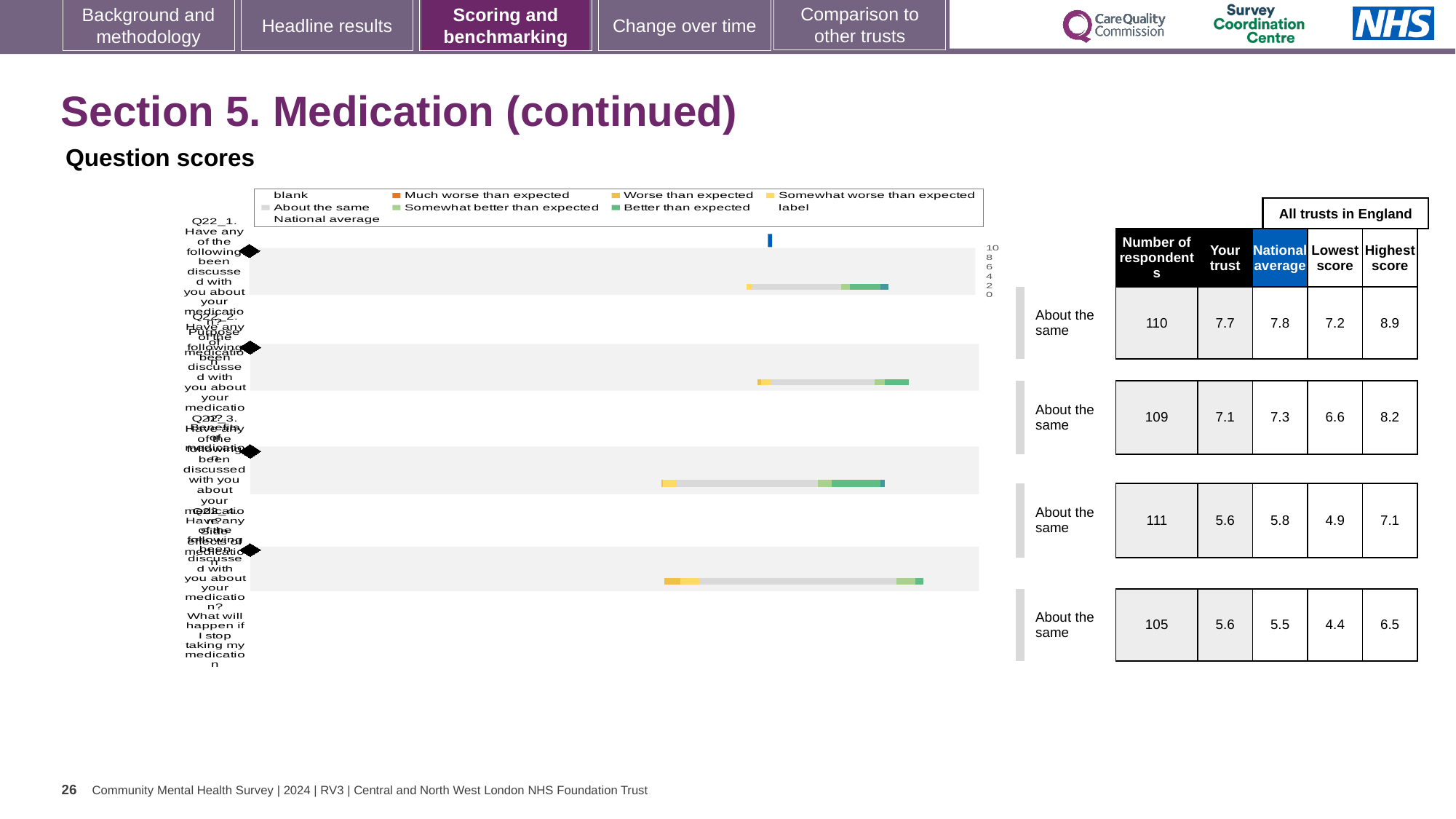
What benchmark category is shown for every question row in the chart? About the same In the table next to the chart, what is the 'Your trust' score in the first row (Q22_1)? 7.7 How many question bars (rows) are plotted in the question scores chart? 4 In the table next to the chart, what is the number of respondents in the second row? 109 In the third row of the table, which is larger: the 'Your trust' score or the national average? National average (5.8) What heading appears above the 'National average', 'Lowest score' and 'Highest score' columns of the table? All trusts in England In the first row of the table, what is the difference between the national average (7.8) and the 'Your trust' score (7.7)? 0.1 What kind of chart is used to show the question scores on this slide? bar chart In the table next to the chart, what is the 'Highest score' in the fourth (bottom) row? 6.5 In the table next to the chart, which row has the lowest 'Lowest score'? the fourth row (4.4) In the table next to the chart, which row has the highest 'Highest score'? the first row (8.9)